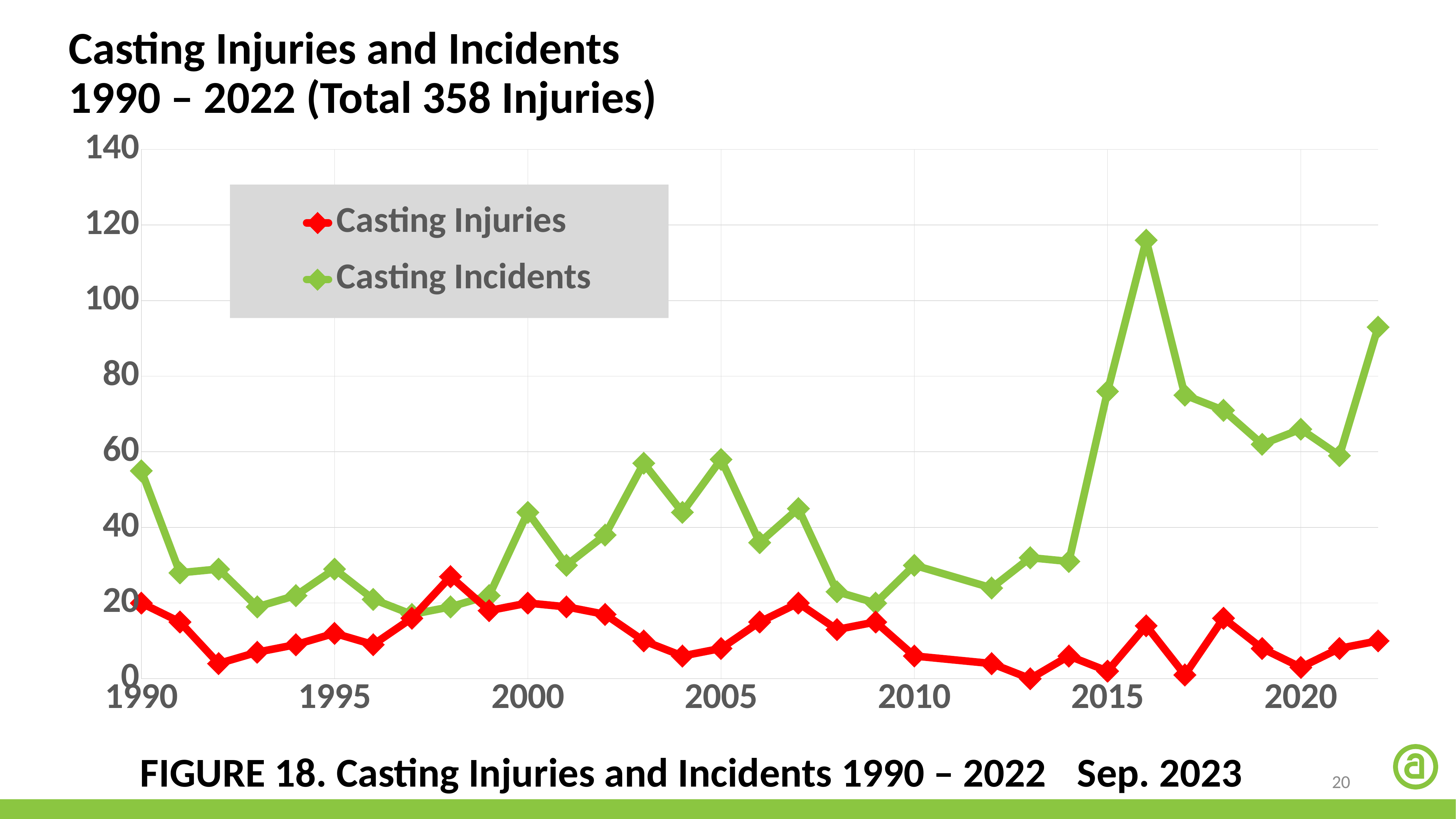
Is the value for Casting Incidents in 1990 greater or less than 40? greater In 2016, which series has the higher value, Casting Injuries or Casting Incidents? Casting Incidents What are the two series named in the legend? Casting Injuries and Casting Incidents Is the value for Casting Injuries in 2013 greater or less than 20? less Is the value for Casting Injuries in 1998 greater or less than 20? greater What kind of chart is shown on the slide? Line chart How many series does the legend list? 2 In which year does the Casting Incidents series reach its highest value? 2016 Which colour is used for the Casting Incidents line? Green Does the Casting Incidents line rise or fall between 2014 and 2016? Rise